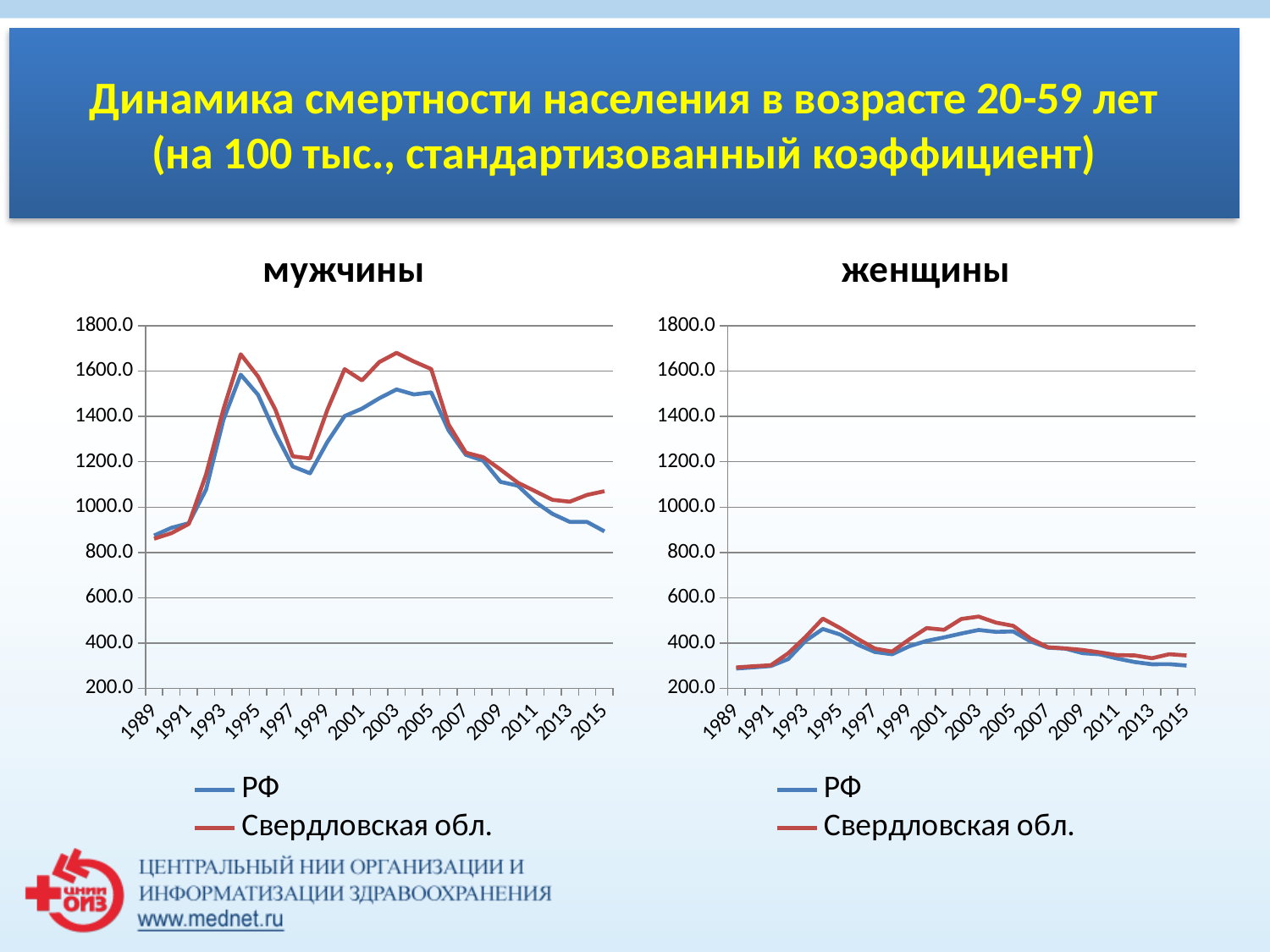
On the "мужчины" chart, which series has the higher value in 2015, РФ or Свердловская обл.? Свердловская обл. On the "мужчины" chart, how many year labels are shown on the x axis? 14 On the "мужчины" chart, is the peak value for Свердловская обл. greater or less than 1600? greater What is the first year shown on the x axis of the "женщины" chart? 1989 What kind of chart is the "мужчины" chart? line chart What colour is the РФ line on the "мужчины" chart? blue On the "мужчины" chart, is the value for РФ in 2015 greater or less than 1000? less On the "женщины" chart, is the highest value for Свердловская обл. greater or less than 600? less How many series does the legend of the "женщины" chart list? 2 On the "мужчины" chart, does the РФ line rise or fall between 2005 and 2015? fall On the "женщины" chart, which series has the higher value in 2003, РФ or Свердловская обл.? Свердловская обл.